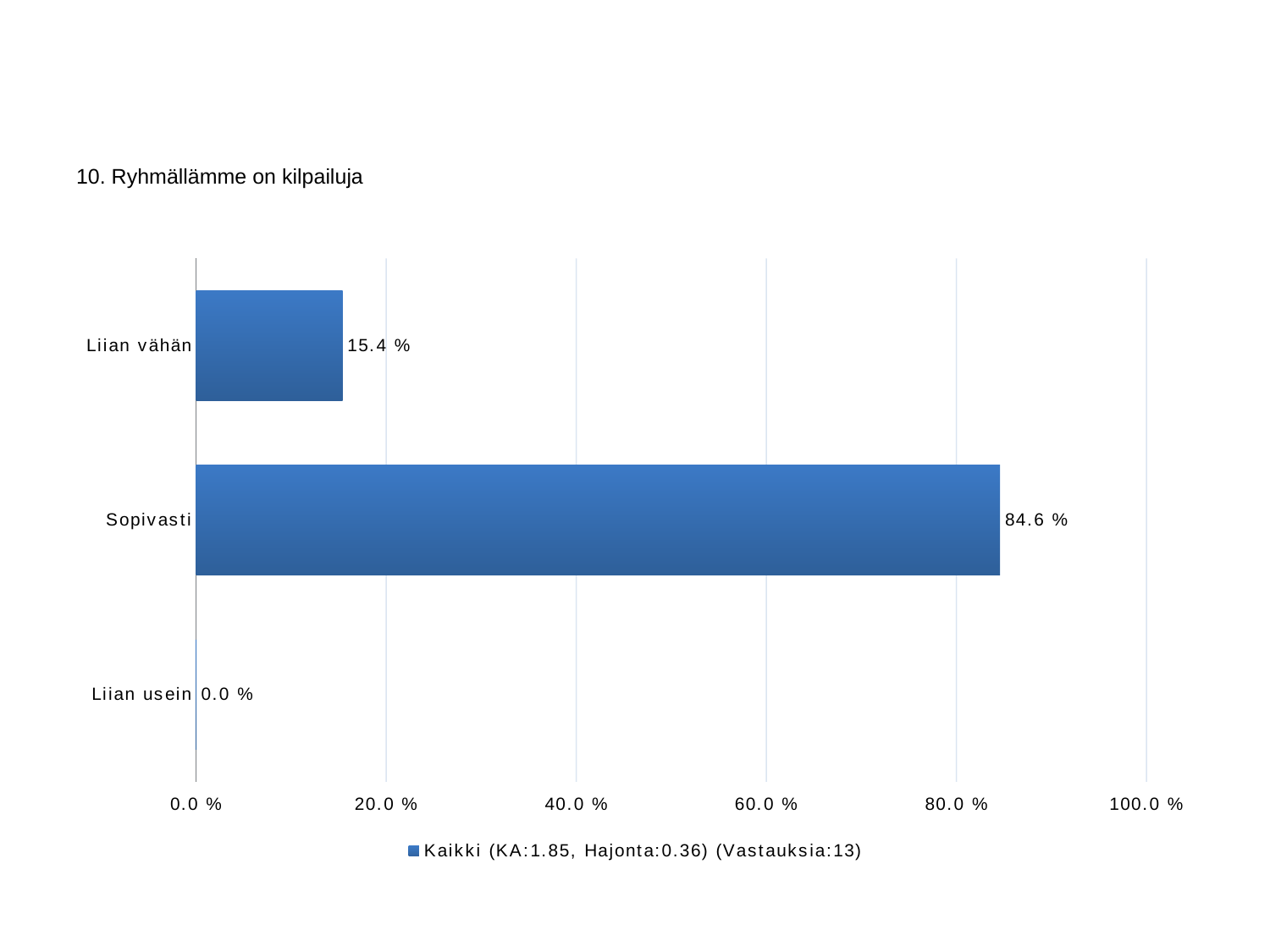
What kind of chart is shown on the slide? bar chart Which category has the lowest value? Liian usein Is the value for Sopivasti greater or less than 80.0 %? greater Which category has the highest value? Sopivasti Which is larger, the value for Liian vähän or the value for Sopivasti? Sopivasti What is the title of the chart? 10. Ryhmällämme on kilpailuja What is the value for Liian vähän? 15.4 % What is the value for Liian usein? 0.0 % What is the value for Sopivasti? 84.6 % How many categories are shown in the chart? 3 What is the difference between the values for Sopivasti and Liian vähän? 69.2 % How many series does the legend list? 1